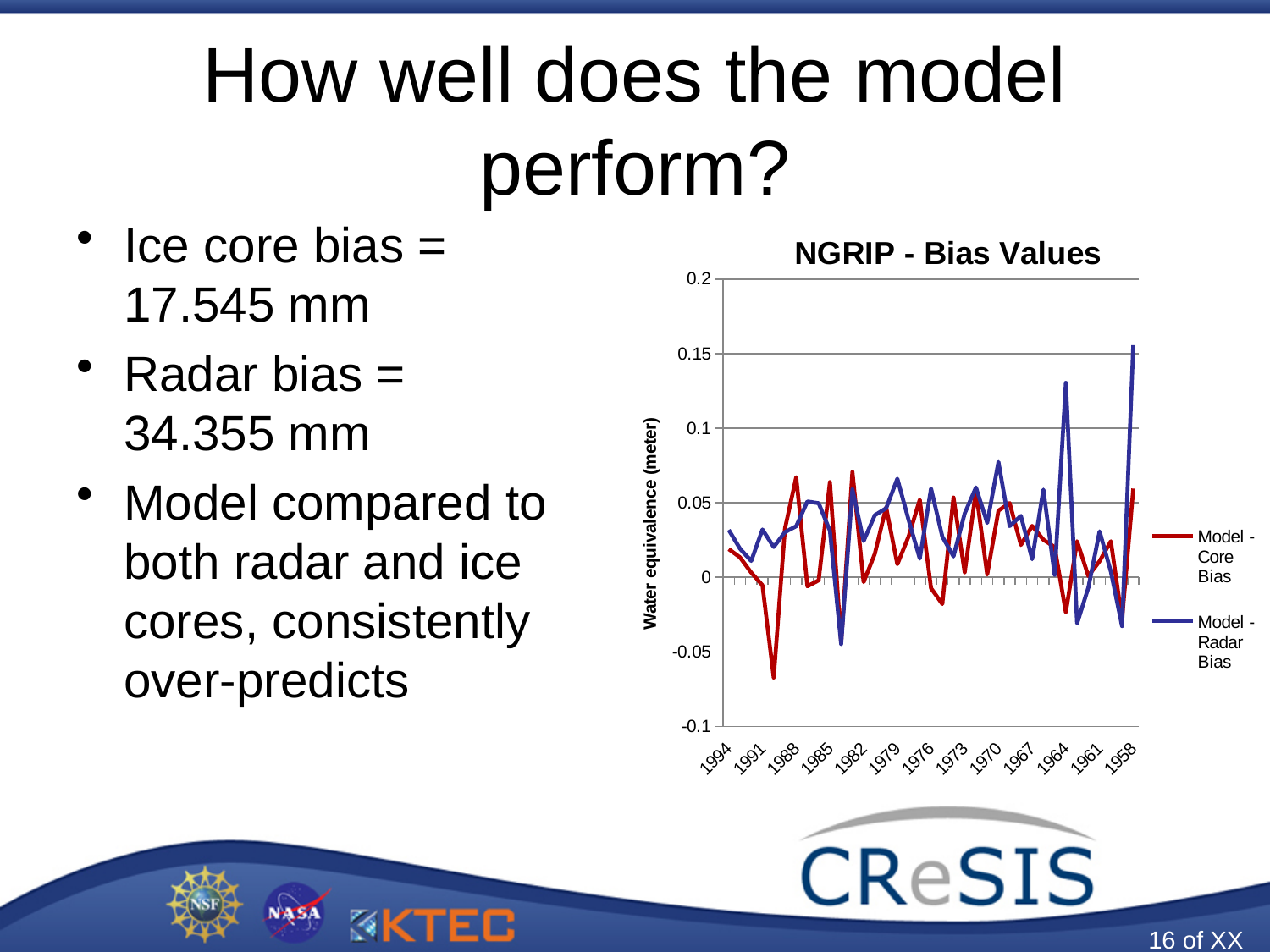
What is the highest value shown on the vertical axis of the chart? 0.2 Is the lowest value of Model - Core Bias (near 1990) greater or less than -0.05? less Which series reaches the lowest value on the chart? Model - Core Bias Is the value of Model - Radar Bias at 1964 greater or less than 0.1? greater Is the value of Model - Radar Bias at 1958 greater or less than 0.1? greater At 1958, which series has the larger value, Model - Core Bias or Model - Radar Bias? Model - Radar Bias What kind of chart is shown on the slide? line chart How many series does the chart's legend list? 2 What is the title of the chart? NGRIP - Bias Values What is the label of the vertical axis of the chart? Water equivalence (meter) Which series reaches the highest value on the chart? Model - Radar Bias